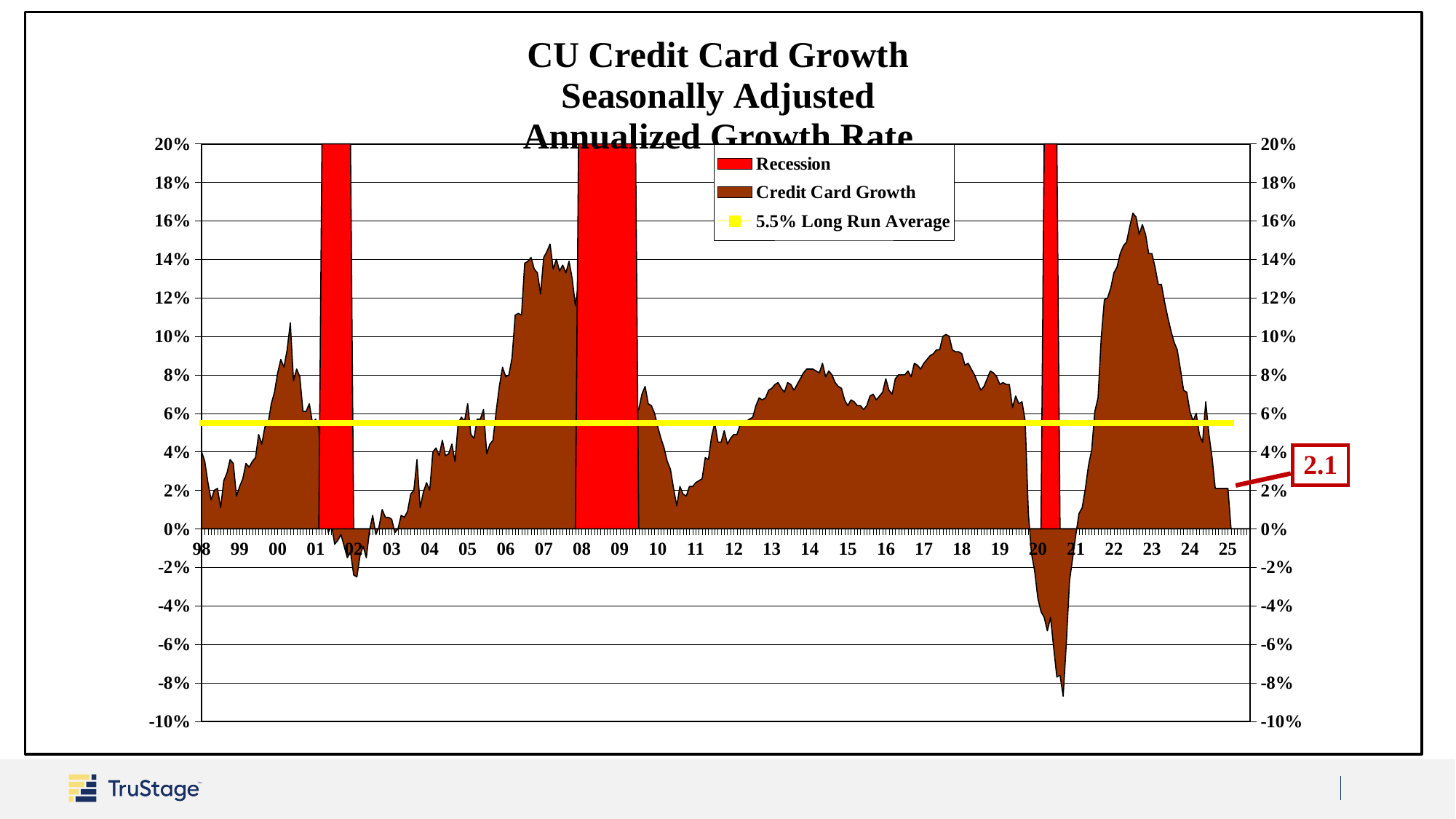
Which peak of Credit Card Growth is higher: the one around 2000 or the one around 2007? 2007 What is the most recent value of Credit Card Growth shown in the callout at the right end of the chart? 2.1 What is the long run average growth rate shown by the yellow line? 5.5% Do the Credit Card Growth values rise or fall from 2023 to 2025? fall What kind of chart is shown on the slide? area chart How many entries does the legend list? 3 What colour are the recession bars on the chart? red How many recession bars are shown on the chart? 3 What is the title of the chart? CU Credit Card Growth Seasonally Adjusted Annualized Growth Rate Is the lowest value of Credit Card Growth around 2020 greater or less than -6%? less Is the peak value of Credit Card Growth around 2022-23 greater or less than 14%? greater Is the most recent Credit Card Growth value above or below the 5.5% long run average? below